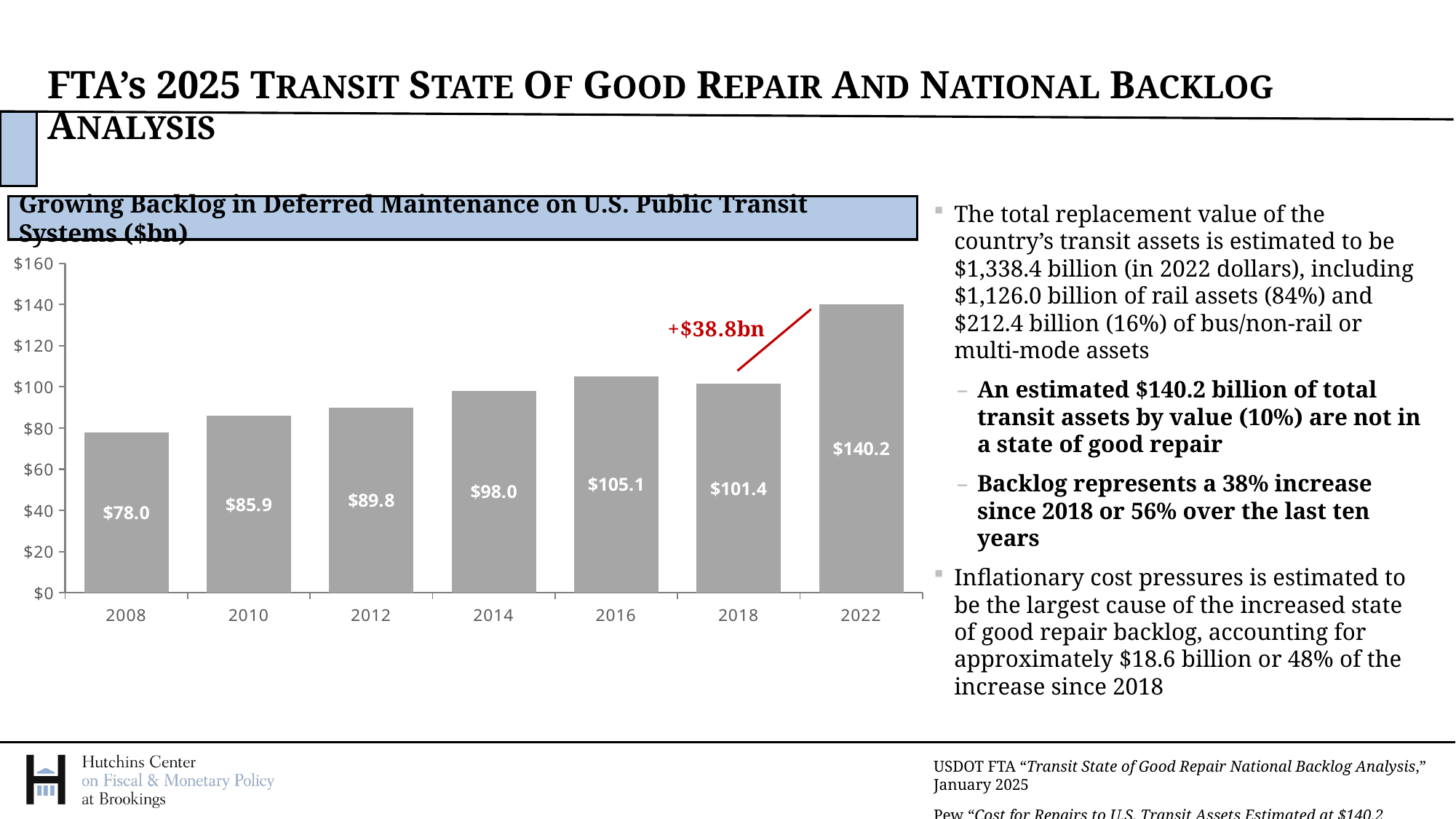
Which is larger, the backlog value for 2016 or for 2018? 2016 How many years are shown on the x axis of the chart? 7 What is the backlog value shown for 2016? $105.1 Which year has the lowest backlog value? 2008 What kind of chart is shown on the slide? Bar chart Which year has the highest backlog value? 2022 What is the backlog value shown for 2008? $78.0 Do the backlog values generally rise or fall from 2008 to 2022? Rise What is the backlog value shown for 2022? $140.2 What is the difference between the 2022 and 2018 backlog values? $38.8 What increase is annotated in red between 2018 and 2022 on the chart? +$38.8bn Is the value for 2014 greater or less than $100? less